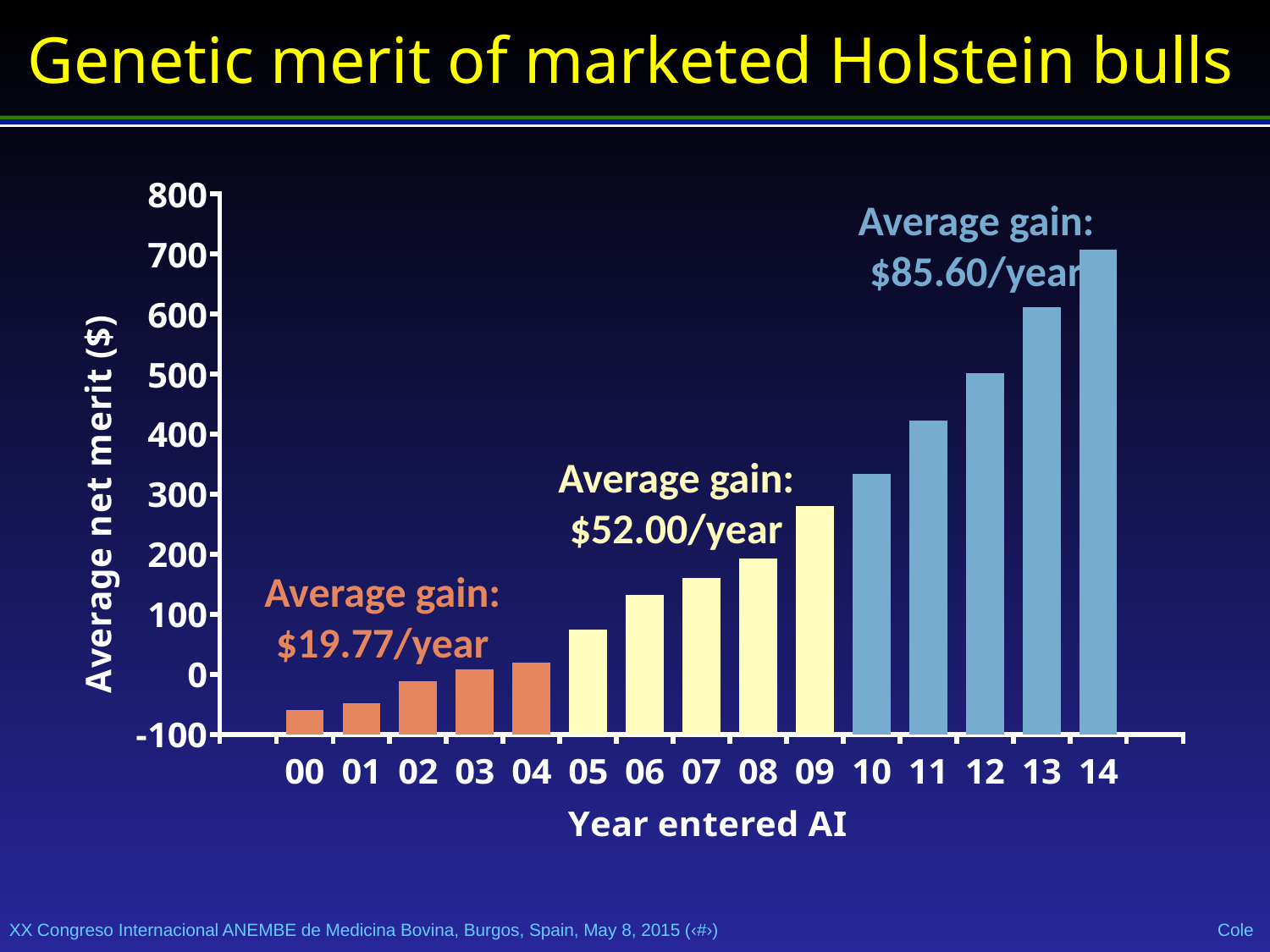
Is the average net merit for year 14 greater or less than 600? greater Is the average net merit for year 11 greater or less than 400? greater Which year entered AI has the highest average net merit? 14 What is the label on the y axis of the chart? Average net merit ($) What kind of chart is shown on the slide? bar chart Which year has the larger average net merit, 09 or 10? 10 Do the average net merit values generally rise or fall from year 00 to year 14? rise How many years (bars) are plotted on the x axis? 15 Is the average net merit for year 09 greater or less than 300? less What average gain per year is annotated for the blue bars (years 10 to 14)? $85.60/year Which year entered AI has the lowest average net merit? 00